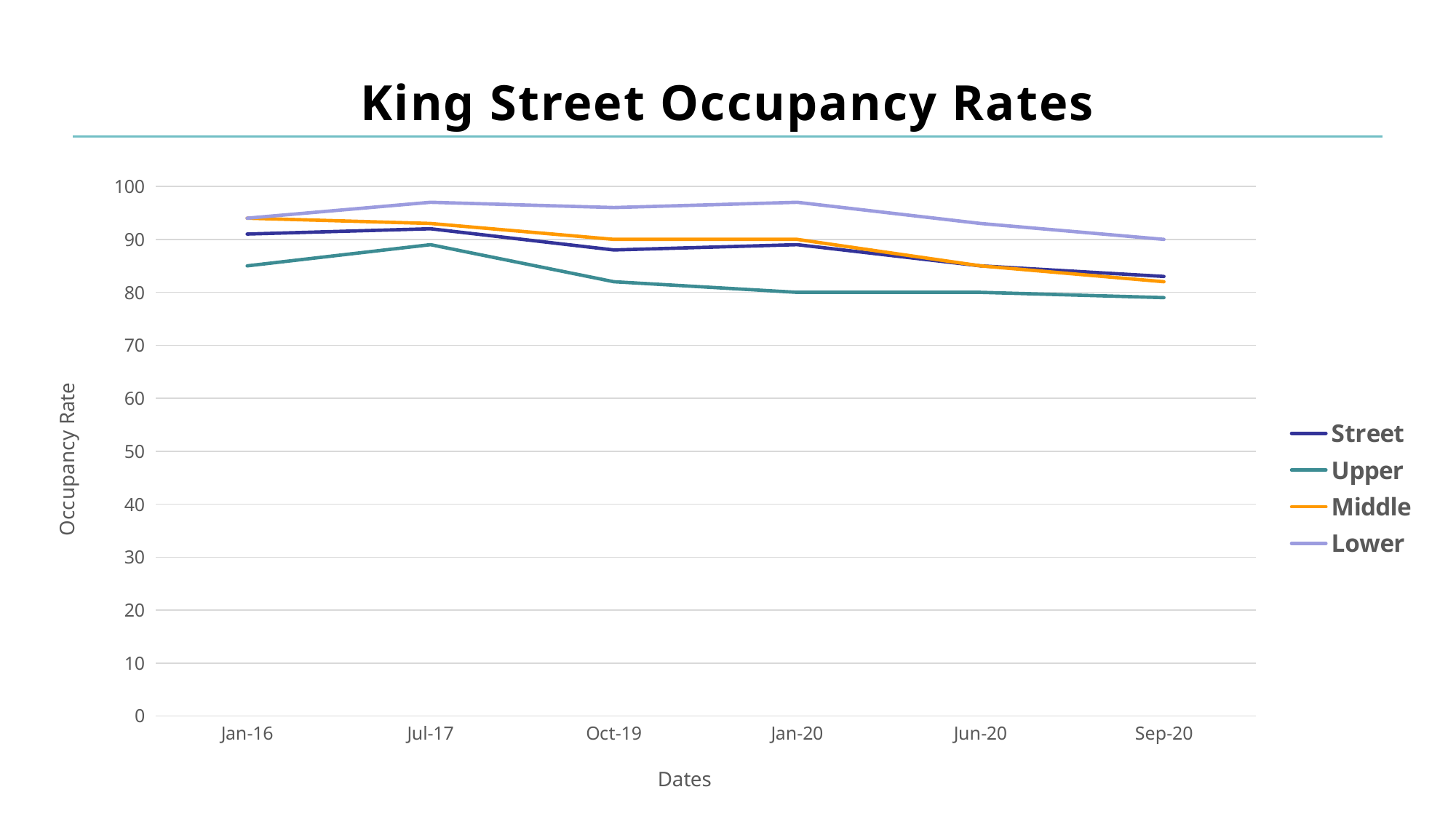
How many dates are shown along the x axis? 6 Is the value for Lower at Jul-17 greater or less than 90? greater Does the Upper series rise or fall from Jan-16 to Jul-17? rise What is the title of the chart? King Street Occupancy Rates Is the value for Upper at Jan-16 greater or less than 90? less What kind of chart is shown on the slide? line chart Which series has the highest value at Jul-17? Lower What is the label on the y axis? Occupancy Rate Which series has the lowest value at Oct-19? Upper Which is larger at Jul-17, Street or Upper? Street How many series does the legend list? 4 Does the Lower series rise or fall from Jan-20 to Sep-20? fall